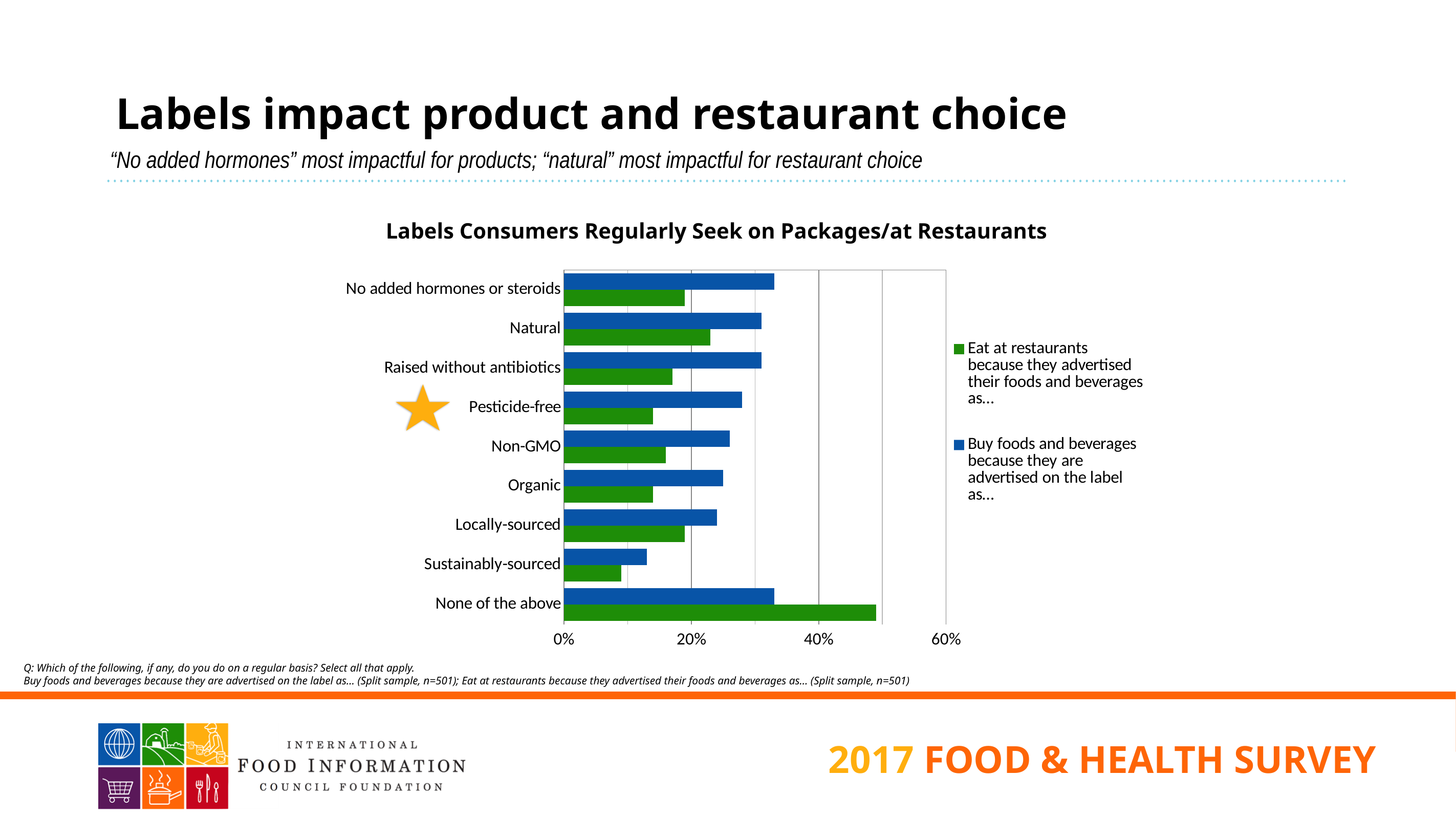
Which category has the lowest value for the 'Buy foods and beverages because they are advertised on the label as...' series? Sustainably-sourced Is the 'Buy foods and beverages' value for Sustainably-sourced greater or less than 20%? less How many label categories are listed on the chart? 9 Is the 'Eat at restaurants' value for None of the above greater or less than 40%? greater Which category has the highest value for the 'Eat at restaurants because they advertised their foods and beverages as...' series? None of the above For Natural, which series has the larger value: 'Buy foods and beverages' or 'Eat at restaurants'? Buy foods and beverages Is the 'Buy foods and beverages' value for Pesticide-free greater or less than 20%? greater What is the title of the chart? Labels Consumers Regularly Seek on Packages/at Restaurants How many series does the legend list? 2 Which category has the lowest value for the 'Eat at restaurants because they advertised their foods and beverages as...' series? Sustainably-sourced What kind of chart is shown on the slide? bar chart